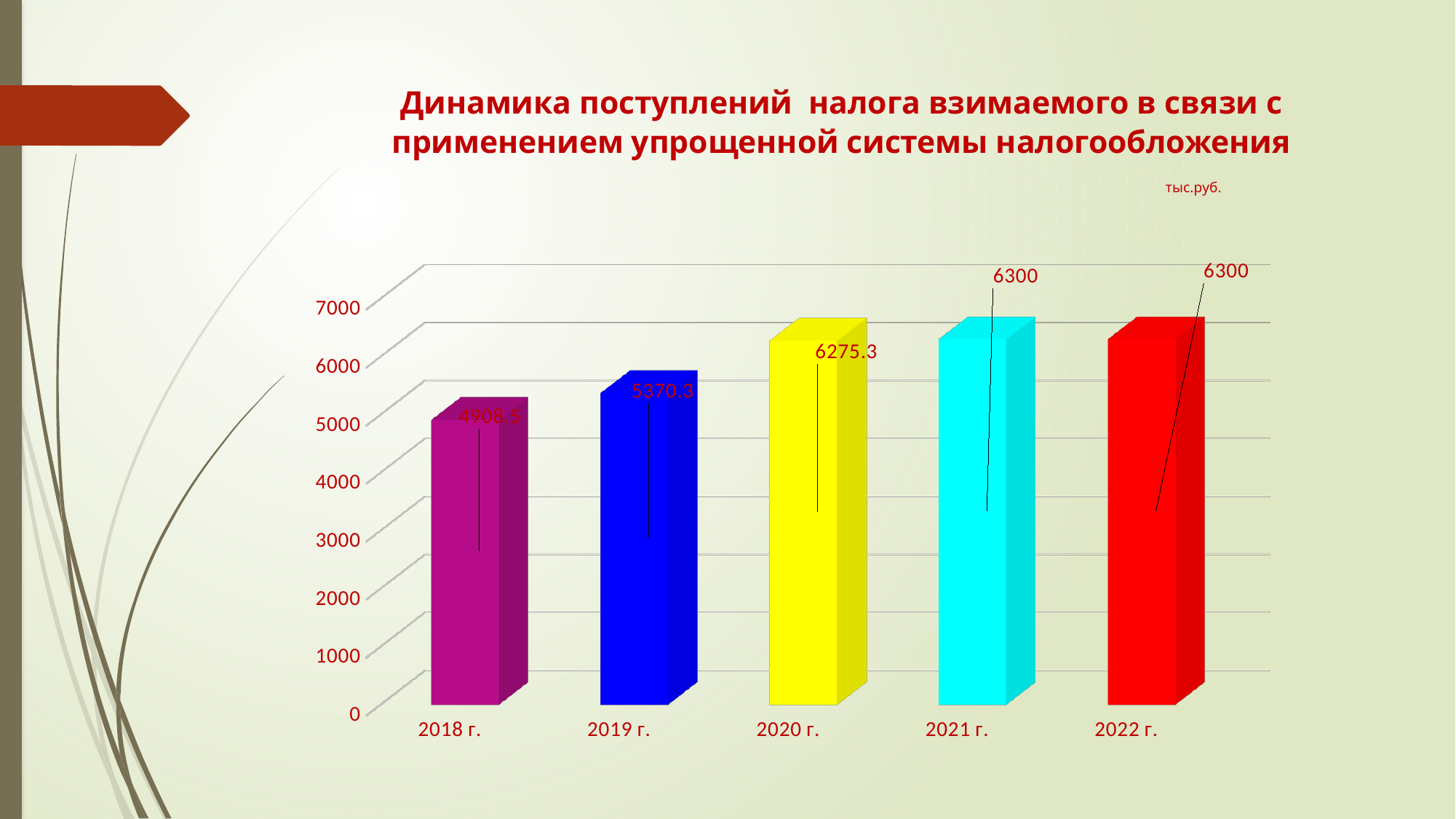
Do the values rise or fall from 2018 г. to 2022 г.? rise How many years are shown on the x axis? 5 What is the difference between the values for 2019 г. and 2018 г.? 461.8 Which is larger, the value for 2020 г. or the value for 2019 г.? 2020 г. What kind of chart is shown on the slide? bar chart Is the value for 2018 г. greater or less than 5000? less What is the value for 2020 г.? 6275.3 What is the value for 2019 г.? 5370.3 What is the value for 2018 г.? 4908.5 Which year has the lowest value? 2018 г. What is the difference between the values for 2021 г. and 2020 г.? 24.7 What is the value for 2021 г.? 6300